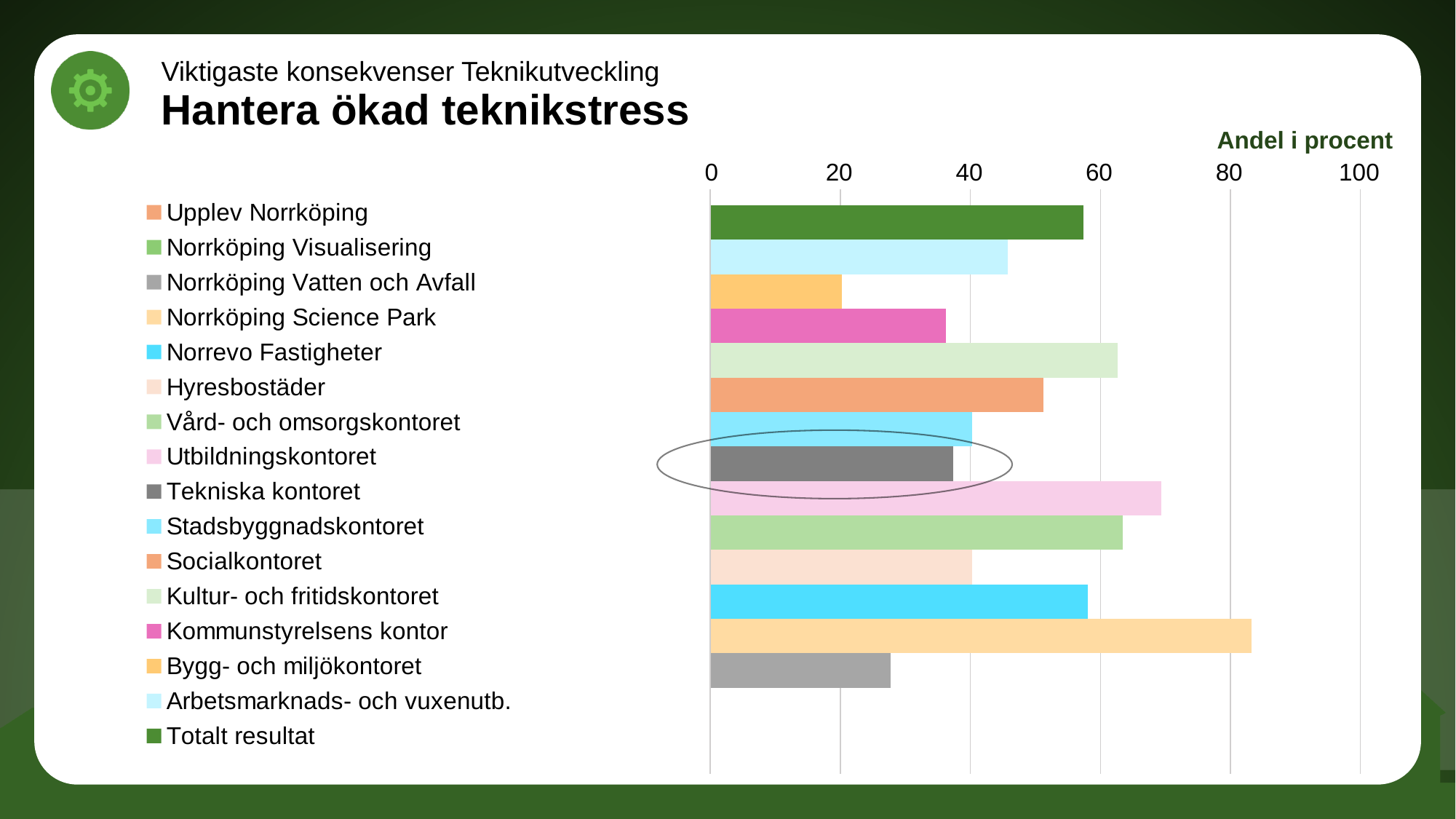
Which bar is circled on the chart? Tekniska kontoret Is the value for Kommunstyrelsens kontor greater or less than 40? less What kind of chart is shown on the slide? bar chart How many entries does the legend list? 16 Is the value for Utbildningskontoret greater or less than 60? greater Which is larger, the value for Norrevo Fastigheter or the value for Hyresbostäder? Norrevo Fastigheter Is the value for Totalt resultat greater or less than 40? greater What is the title shown above the horizontal axis? Andel i procent Which legend entry has the longest bar? Norrköping Science Park Which is larger, the value for Utbildningskontoret or the value for Socialkontoret? Utbildningskontoret